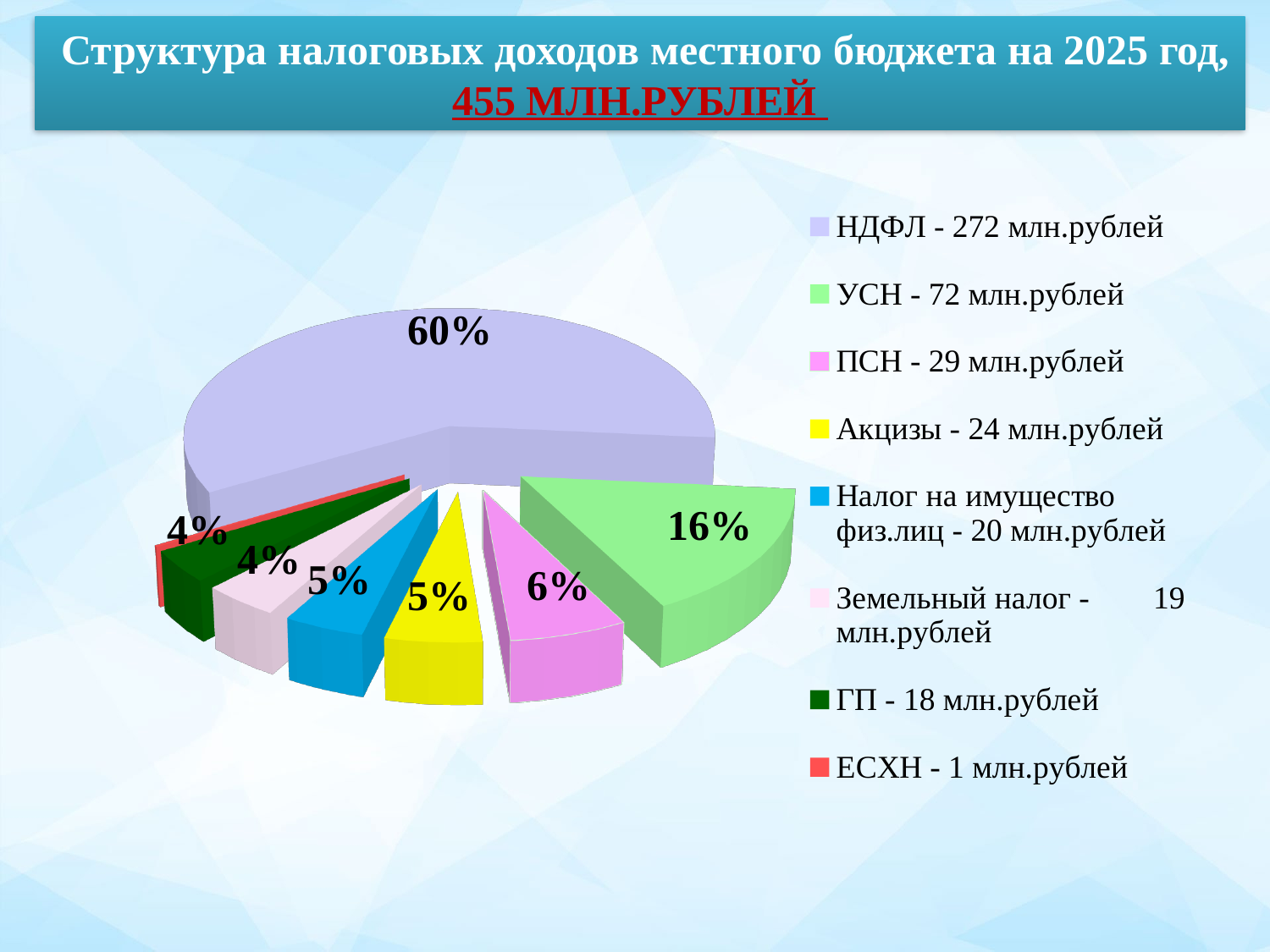
How many categories does the legend list? 8 Which category has the largest slice of the pie? НДФЛ According to the legend, how many million rubles does УСН contribute? 72 млн.рублей What share of the pie does УСН account for? 16% What share of the pie does Земельный налог account for? 4% By how many million rubles does НДФЛ exceed УСН according to the legend? 200 млн.рублей What share of the pie does ПСН account for? 6% What kind of chart is shown on the slide? pie chart Which is larger, the slice for ПСН or the slice for Акцизы? ПСН What share of the pie does Акцизы account for? 5% What share of the pie does НДФЛ account for? 60% Which category has the smallest slice of the pie? ЕСХН